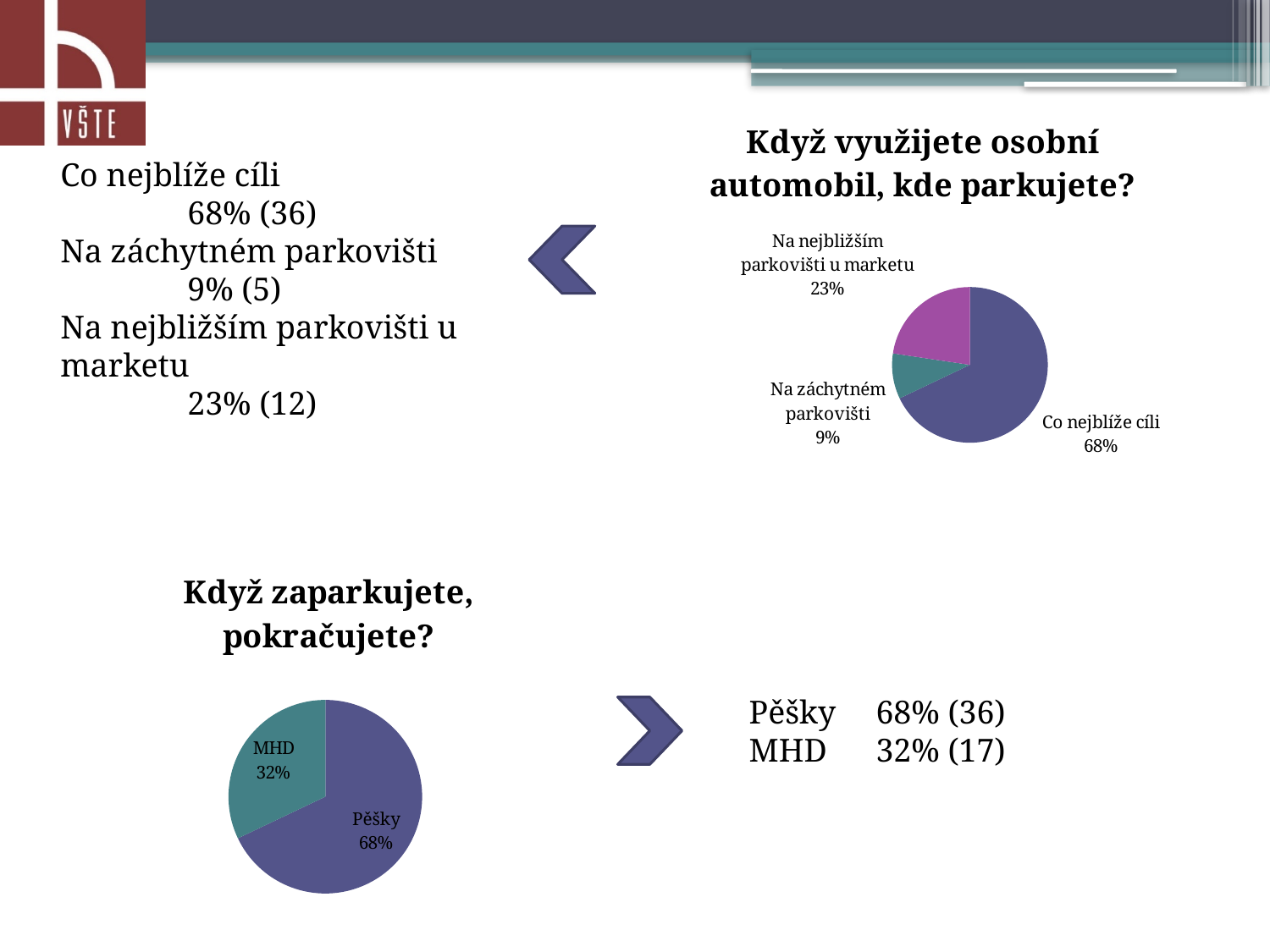
In the chart titled "Když využijete osobní automobil, kde parkujete?", what share does "Co nejblíže cíli" have? 68% In the chart titled "Když zaparkujete, pokračujete?", what share does "MHD" have? 32% In the chart titled "Když zaparkujete, pokračujete?", what share does "Pěšky" have? 68% In the chart titled "Když využijete osobní automobil, kde parkujete?", which category has the largest slice? Co nejblíže cíli In the chart titled "Když využijete osobní automobil, kde parkujete?", which category has the smallest slice? Na záchytném parkovišti In the chart titled "Když zaparkujete, pokračujete?", which is larger, "Pěšky" or "MHD"? Pěšky In the chart titled "Když využijete osobní automobil, kde parkujete?", how many slices does the pie have? 3 In the chart titled "Když využijete osobní automobil, kde parkujete?", what is the difference in percentage points between "Co nejblíže cíli" and "Na nejbližším parkovišti u marketu"? 45 percentage points What kind of chart is the one titled "Když zaparkujete, pokračujete?"? Pie chart In the chart titled "Když zaparkujete, pokračujete?", what is the difference in percentage points between "Pěšky" and "MHD"? 36 percentage points